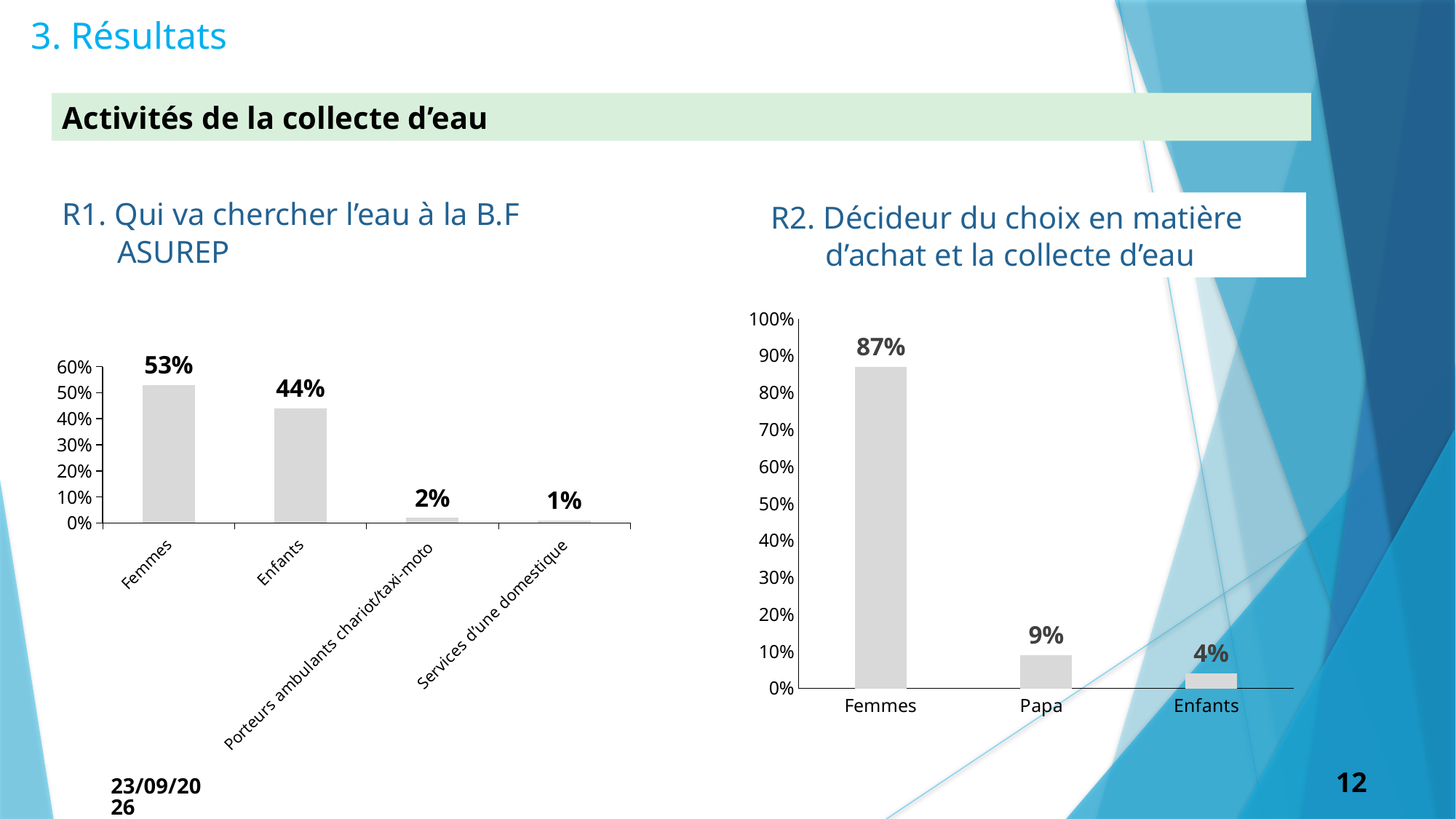
In the left chart (R1), which category has the lowest value? Services d'une domestique In the left chart (R1), how many categories are shown? 4 In the right chart (R2), which is larger, the value for Papa or the value for Enfants? Papa In the right chart (R2), what is the value for Papa? 9% In the left chart (R1), what is the value for Enfants? 44% What kind of chart is the right chart (R2)? Bar chart In the right chart (R2. Décideur du choix en matière d'achat et la collecte d'eau), what is the value for Femmes? 87% In the right chart (R2), which category has the highest value? Femmes In the left chart (R1. Qui va chercher l'eau à la B.F ASUREP), what is the value for Femmes? 53% In the right chart (R2), what is the difference between the values for Femmes and Papa? 78% In the left chart (R1), what is the value for Porteurs ambulants chariot/taxi-moto? 2% In the left chart (R1), what is the difference between the values for Femmes and Enfants? 9%